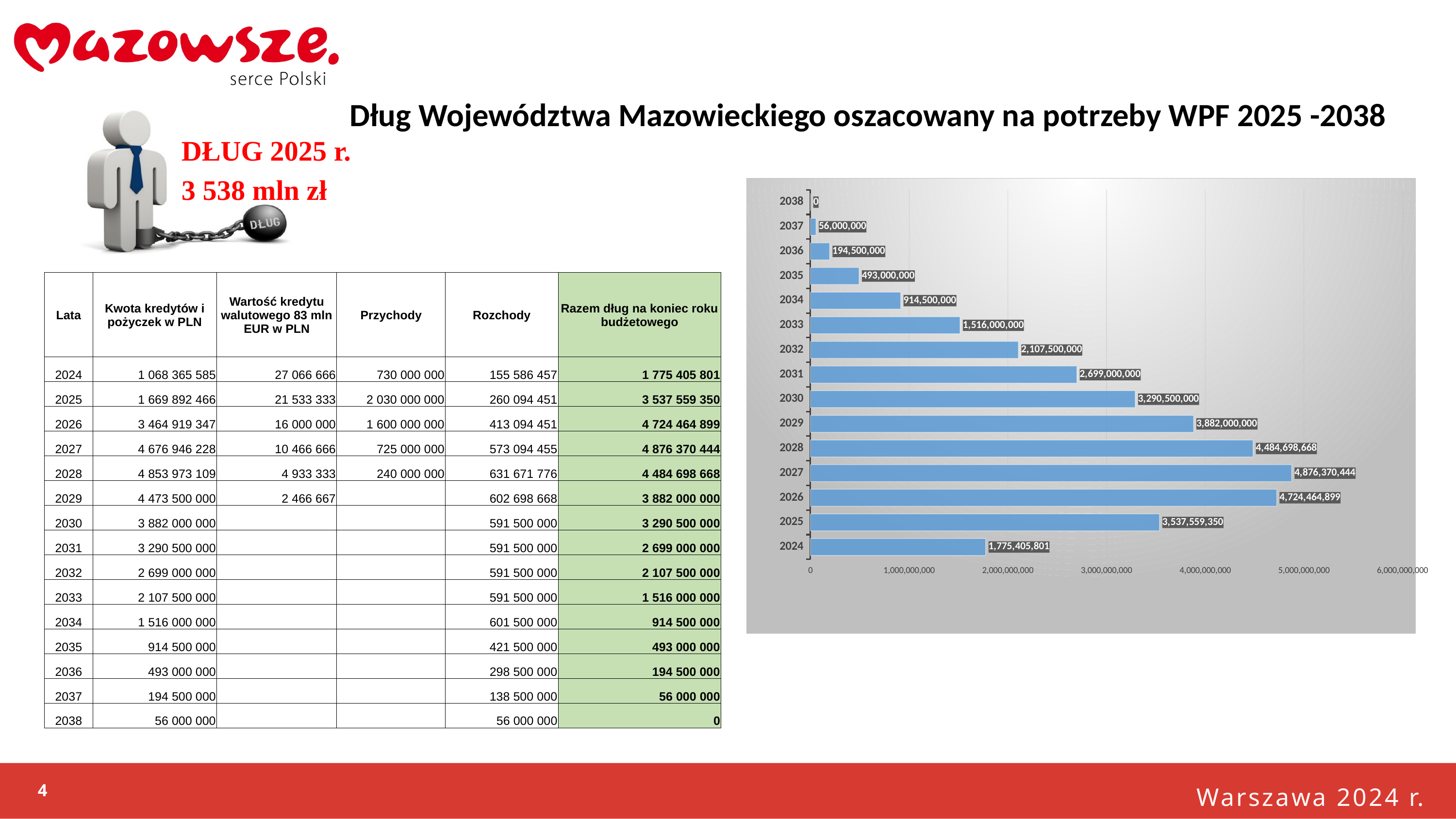
What is the value shown for 2037 in the bar chart? 56,000,000 What type of chart is shown on the right side of the slide? bar chart Which year has the highest value in the bar chart? 2027 What is the difference between the values for 2027 and 2026 in the bar chart? 151,905,545 Do the values in the bar chart rise or fall from 2027 through 2038? fall What is the value shown for 2033 in the bar chart? 1,516,000,000 What is the value shown for 2025 in the bar chart? 3,537,559,350 How many years (bars) are plotted in the bar chart? 15 Is the value for 2031 in the bar chart greater or less than 3,000,000,000? less What is the difference between the values for 2029 and 2030 in the bar chart? 591,500,000 Which is larger in the bar chart, the value for 2028 or the value for 2029? 2028 Which year has the lowest value in the bar chart? 2038